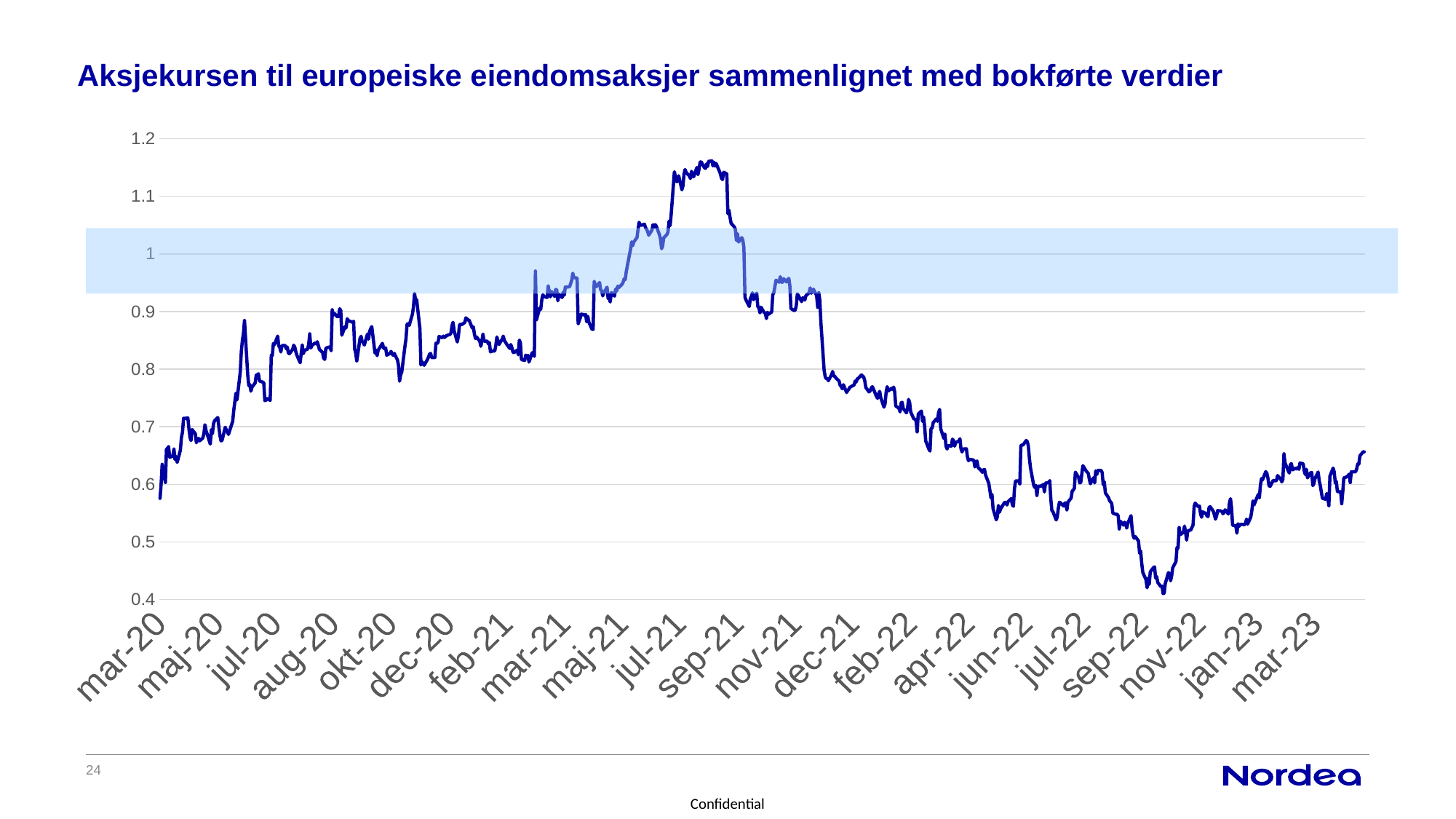
Is the value at dec-20 greater or less than 0.8? greater What kind of chart is shown on the slide? line chart Does the line rise or fall between sep-21 and sep-22? fall Does the line rise or fall between mar-20 and jul-21? rise Around which x-axis label does the line reach its highest point? between jul-21 and sep-21 Around which x-axis label does the line reach its lowest point? sep-22 How many labels are shown on the x axis? 21 What is the title of the chart? Aksjekursen til europeiske eiendomsaksjer sammenlignet med bokførte verdier Is the value at apr-22 greater or less than 0.7? less Is the value at feb-22 greater or less than 0.8? less